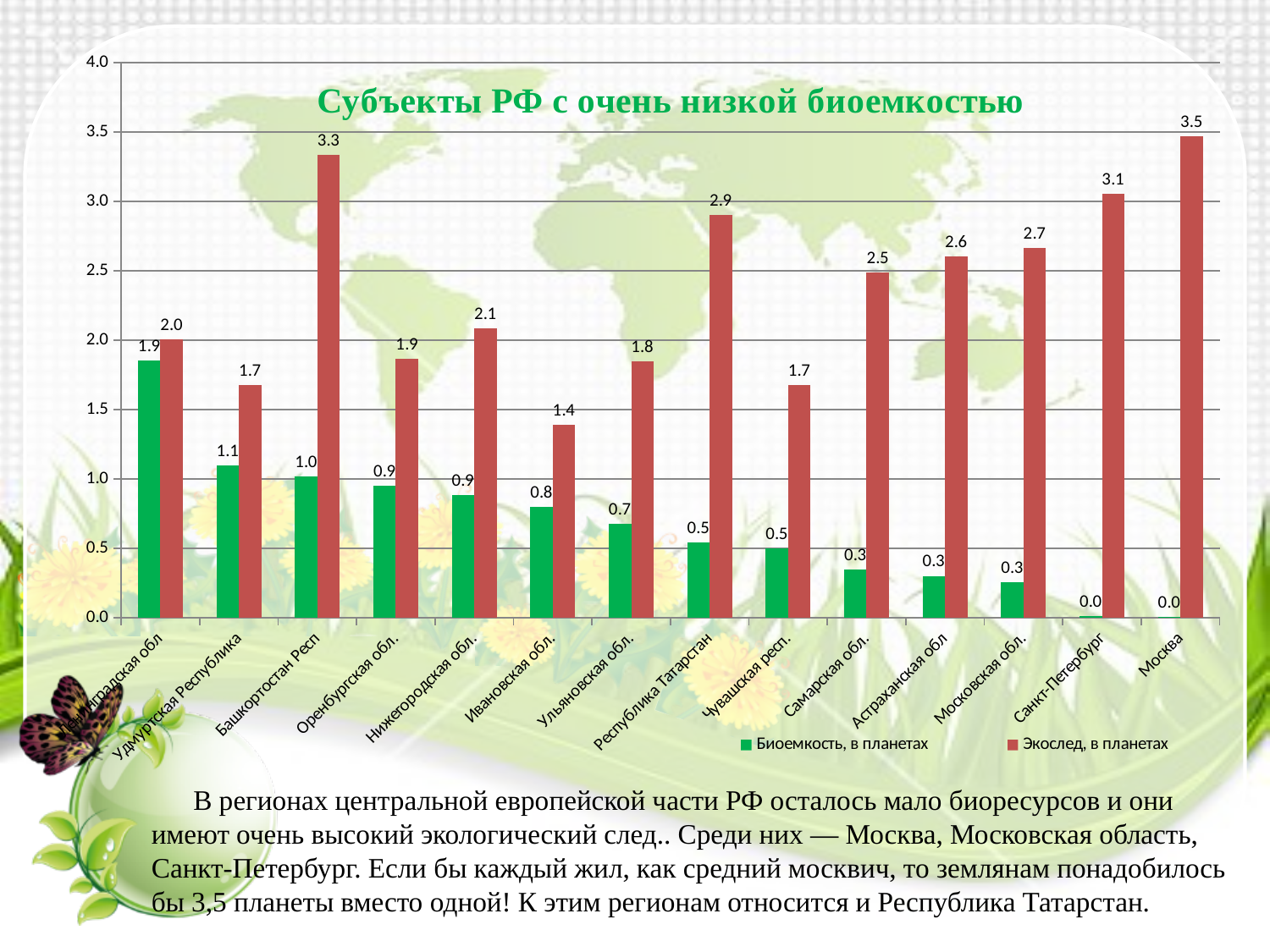
How many categories are shown on the x axis? 14 What kind of chart is shown on the slide? Bar chart Which colour represents the Биоемкость, в планетах series? Green Which category has the lowest Экослед, в планетах value? Ивановская обл. What is the difference between the Экослед and Биоемкость values for Республика Татарстан? 2.4 What is the Экослед, в планетах value for Москва? 3.5 How many series does the legend list? 2 Which is larger: the Экослед value for Санкт-Петербург or for Московская обл.? Санкт-Петербург What is the Экослед, в планетах value for Башкортостан Респ? 3.3 What is the Биоемкость, в планетах value for Удмуртская Республика? 1.1 Which category has the highest Экослед, в планетах value? Москва What is the title of the chart? Субъекты РФ с очень низкой биоемкостью